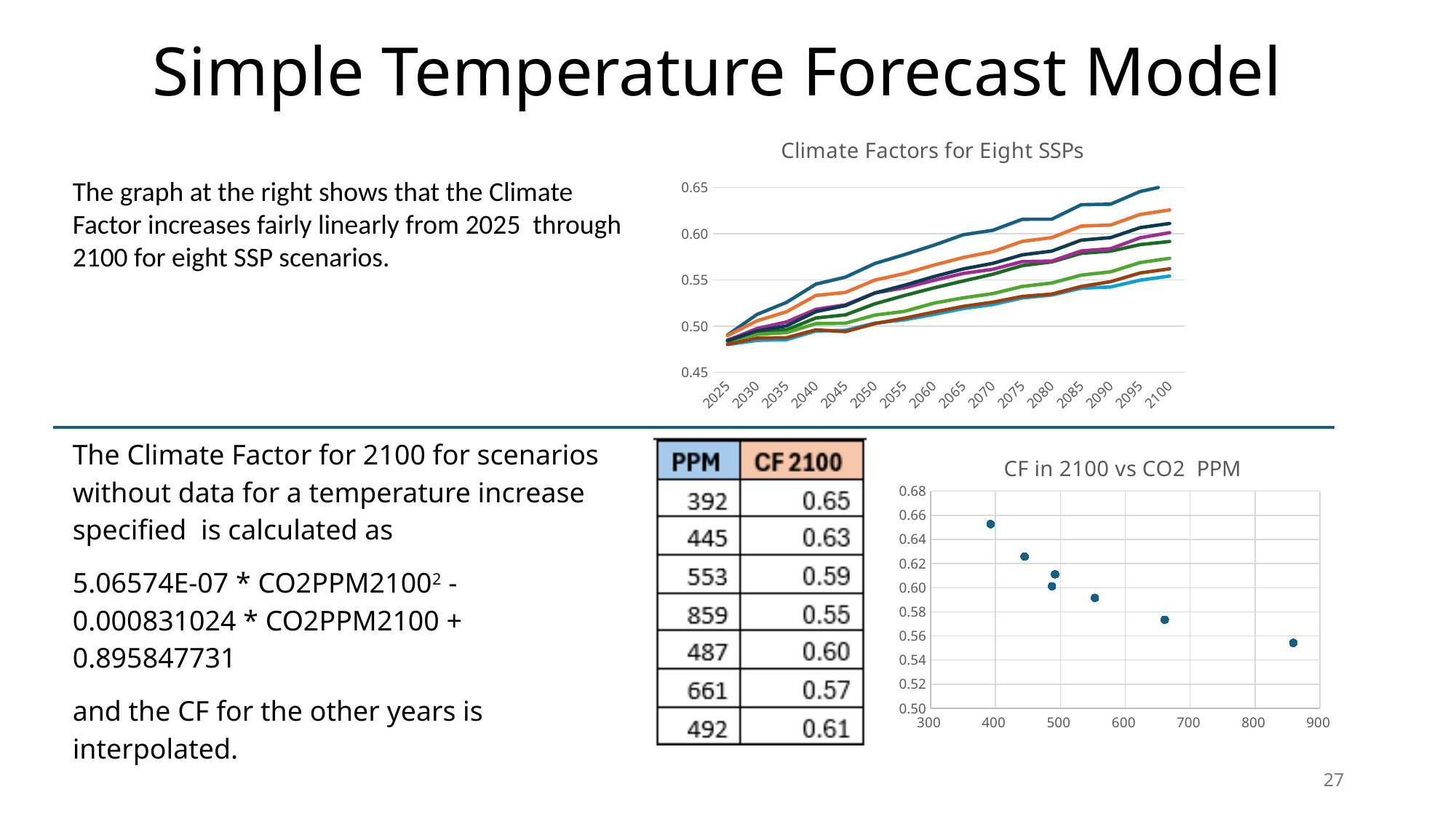
In the 'Climate Factors for Eight SSPs' chart, is the value of the highest line at 2050 greater or less than 0.55? greater In the 'Climate Factors for Eight SSPs' chart, are the values of all lines at 2025 greater or less than 0.50? less In the 'Climate Factors for Eight SSPs' chart, what kind of chart is shown? line chart In the 'Climate Factors for Eight SSPs' chart, is the value of the lowest line at 2100 greater or less than 0.50? greater What is the title of the chart at the bottom right of the slide? CF in 2100 vs CO2 PPM What is the title of the chart at the top right of the slide? Climate Factors for Eight SSPs In the 'CF in 2100 vs CO2 PPM' chart, do the CF values rise or fall as CO2 PPM increases? fall In the 'CF in 2100 vs CO2 PPM' chart, what kind of chart is shown? scatter chart In the 'Climate Factors for Eight SSPs' chart, how many year labels are shown on the x axis? 16 In the 'CF in 2100 vs CO2 PPM' chart, how many data points are plotted? 7 In the 'Climate Factors for Eight SSPs' chart, do the values rise or fall from 2025 to 2100? rise